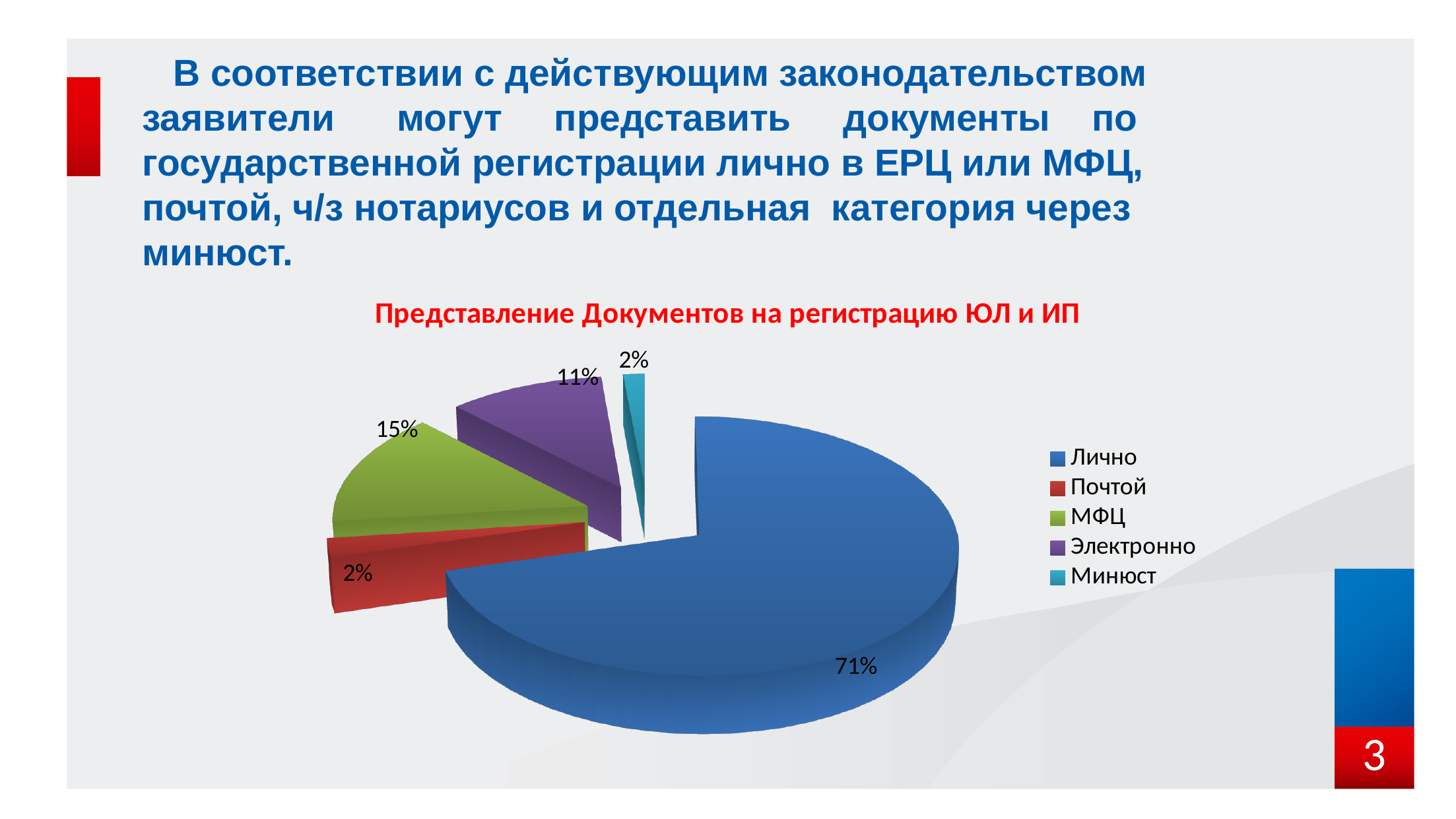
What is the value shown for Минюст? 2% What share of the pie does Лично account for? 71% What type of chart is shown on the slide? Pie chart What is the value shown for Почтой? 2% What is the value shown for МФЦ? 15% What colour is the slice for Электронно? Purple Which category has the largest slice of the pie? Лично What is the difference between the values for Лично and МФЦ? 56% What is the value shown for Электронно? 11% Which is larger, МФЦ or Электронно? МФЦ How many categories does the legend list? 5 What is the title of the chart? Представление Документов на регистрацию ЮЛ и ИП